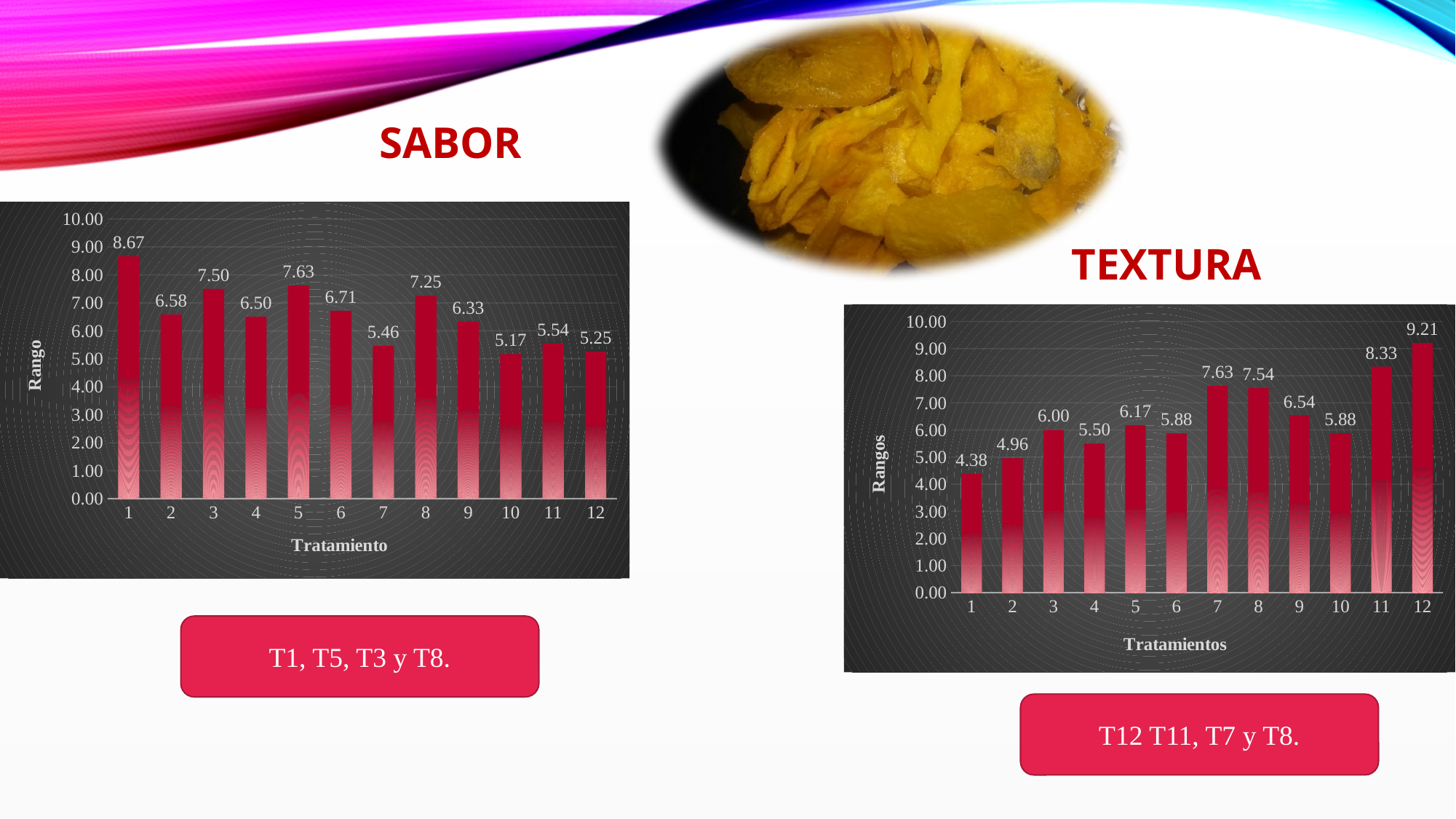
In the SABOR chart, which treatment has the lowest value? 10 In the SABOR chart, which is larger, treatment 3 or treatment 8? Treatment 3 In the TEXTURA chart, is the value for treatment 9 greater or less than 6.00? greater In the SABOR chart, what is the label of the x axis? Tratamiento What kind of chart is the TEXTURA chart? Bar chart In the TEXTURA chart, what is the value for treatment 12? 9.21 In the TEXTURA chart, which treatment has the highest value? 12 In the SABOR chart, what is the value for treatment 1? 8.67 In the SABOR chart, what is the difference between treatment 1 and treatment 5? 1.04 In the TEXTURA chart, which treatment has the lowest value? 1 In the SABOR chart, how many treatments are plotted? 12 In the TEXTURA chart, what is the difference between treatment 11 and treatment 7? 0.70